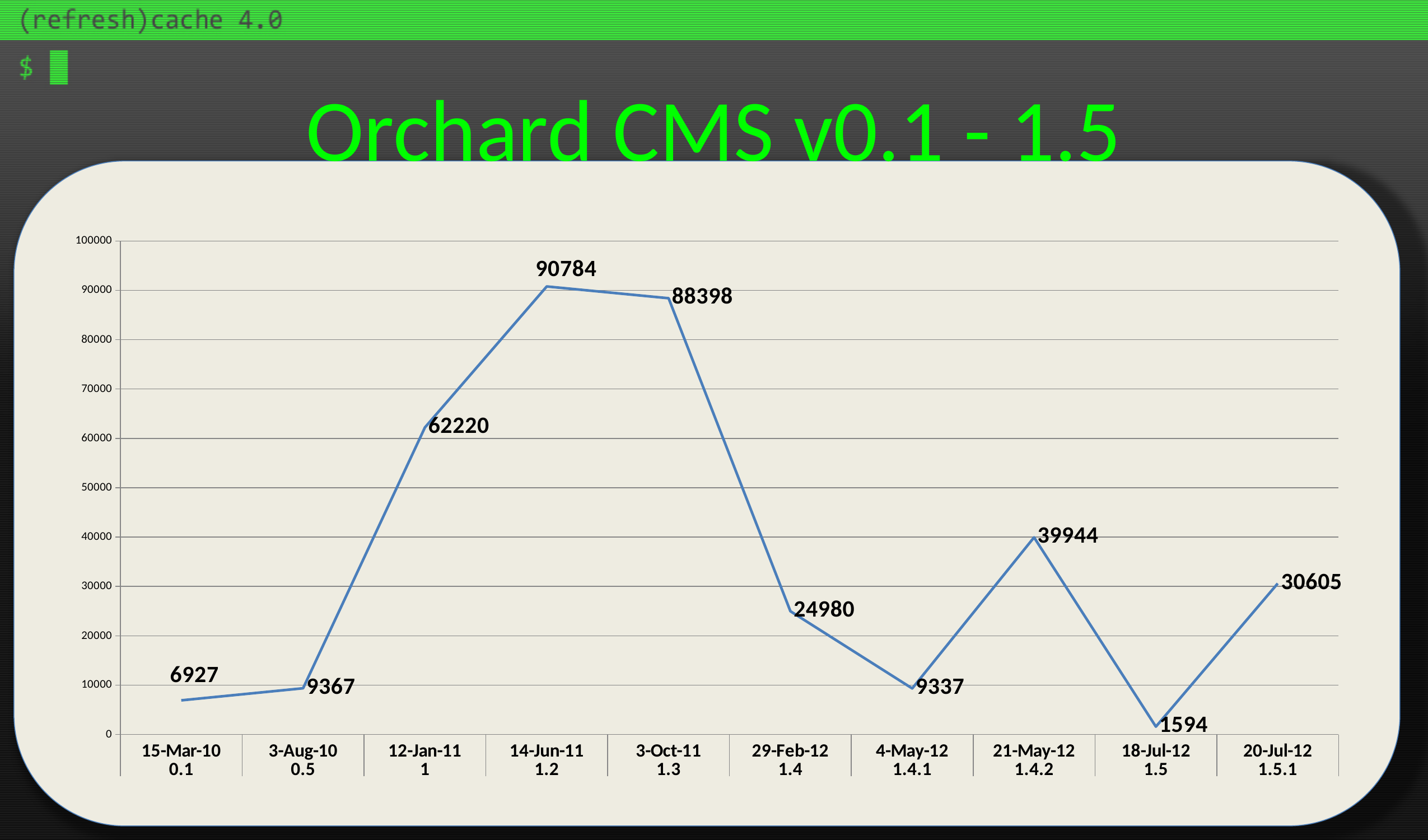
Is the value for version 1 (12-Jan-11) greater or less than 60000? greater Which version has the lowest value? 1.5 (18-Jul-12) How many data points are plotted on the chart? 10 What is the value for version 0.1 (15-Mar-10)? 6927 What is the value for version 1.5 (18-Jul-12)? 1594 What is the value for version 1.4.2 (21-May-12)? 39944 What is the value for version 1.2 (14-Jun-11)? 90784 What kind of chart is shown on the slide? line chart Does the value rise or fall from version 1.4.2 to version 1.5? fall Which version has the highest value? 1.2 (14-Jun-11) Which is larger, the value for version 1.4 or the value for version 1.5.1? 1.5.1 What is the difference between the values for version 1.2 and version 1.3? 2386